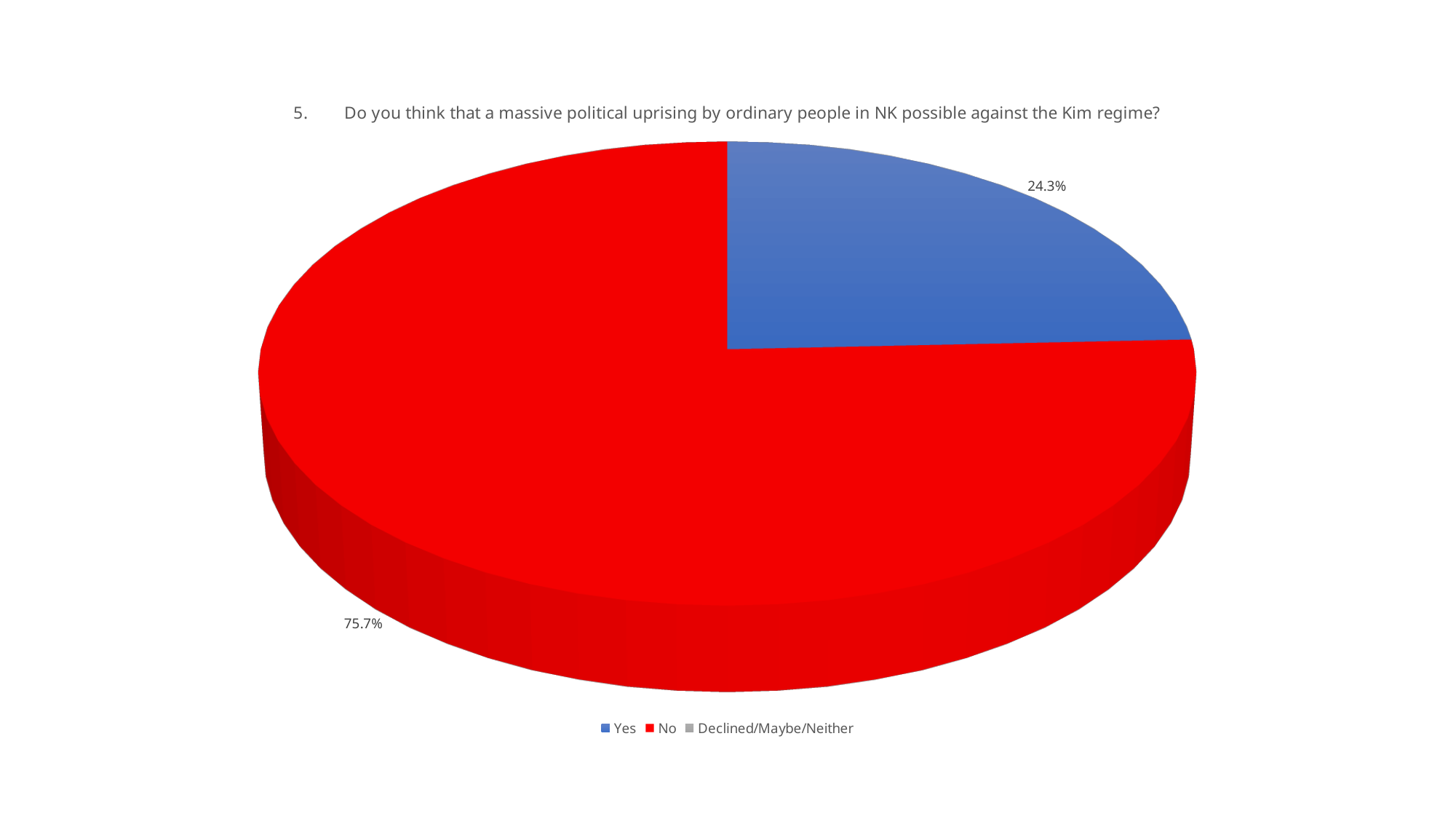
Is the share for "Yes" greater or less than 50%? less What share of respondents answered "Yes"? 24.3% How many entries does the legend list? 3 Which response has the largest slice of the pie? No What colour is the "Yes" slice? blue What colour is the "No" slice? red What is the difference in percentage points between the "No" and "Yes" slices? 51.4 What share of respondents answered "No"? 75.7% What kind of chart is shown on the slide? pie chart How many slices with printed percentage labels are visible in the pie? 2 Which of the two labelled slices is larger, "Yes" or "No"? No